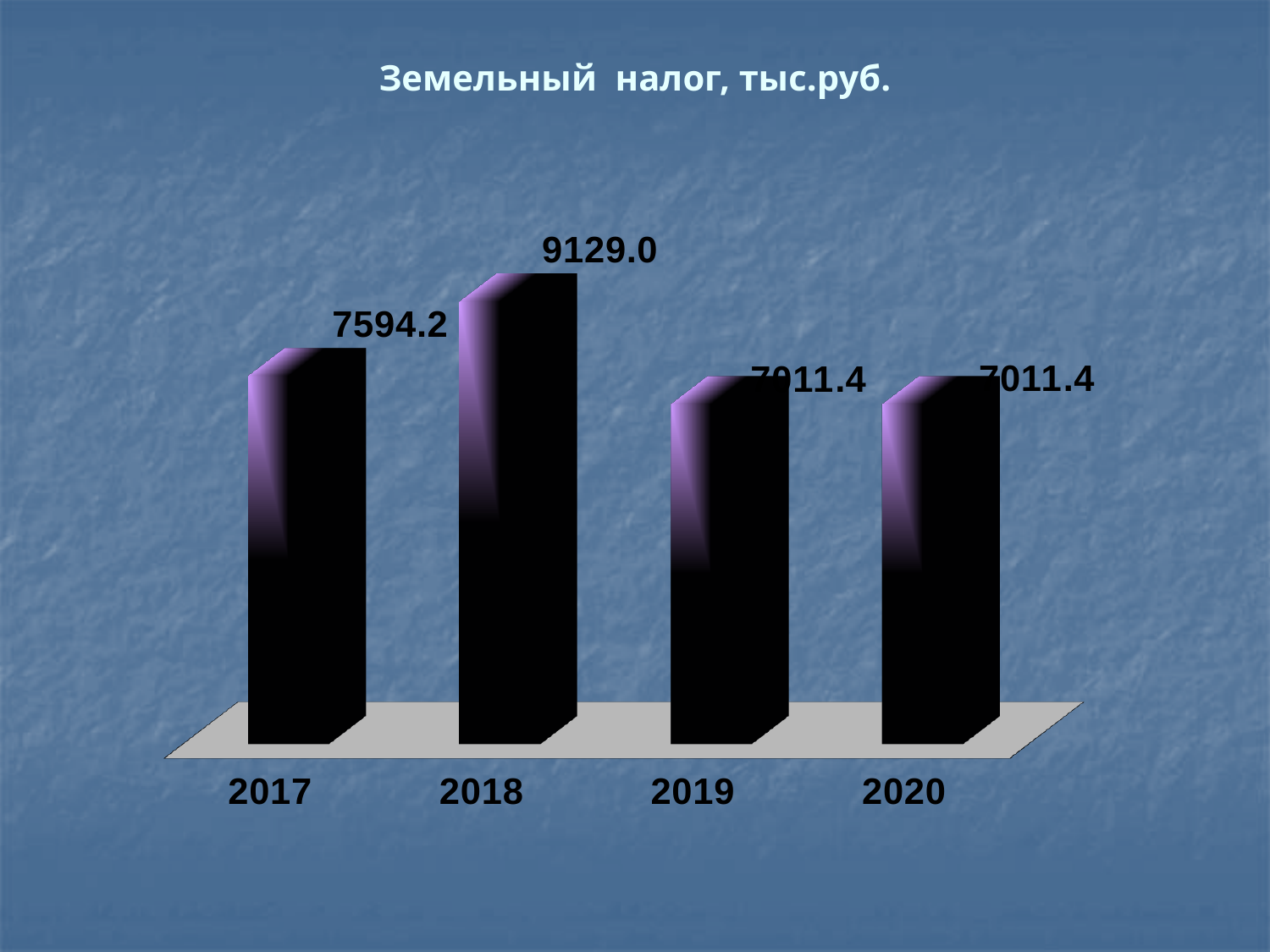
What is the title of the chart? Земельный налог, тыс.руб. Does the value rise or fall from 2017 to 2018? Rise Which is larger, the value for 2017 or the value for 2020? 2017 Which is larger, the value for 2018 or the value for 2019? 2018 What is the value for 2017? 7594.2 What kind of chart is shown on the slide? Bar chart What is the value for 2020? 7011.4 What is the difference between the values for 2018 and 2017? 1534.8 How many years are shown on the chart? 4 What is the difference between the values for 2017 and 2020? 582.8 What is the value for 2018? 9129.0 Which year has the highest value? 2018